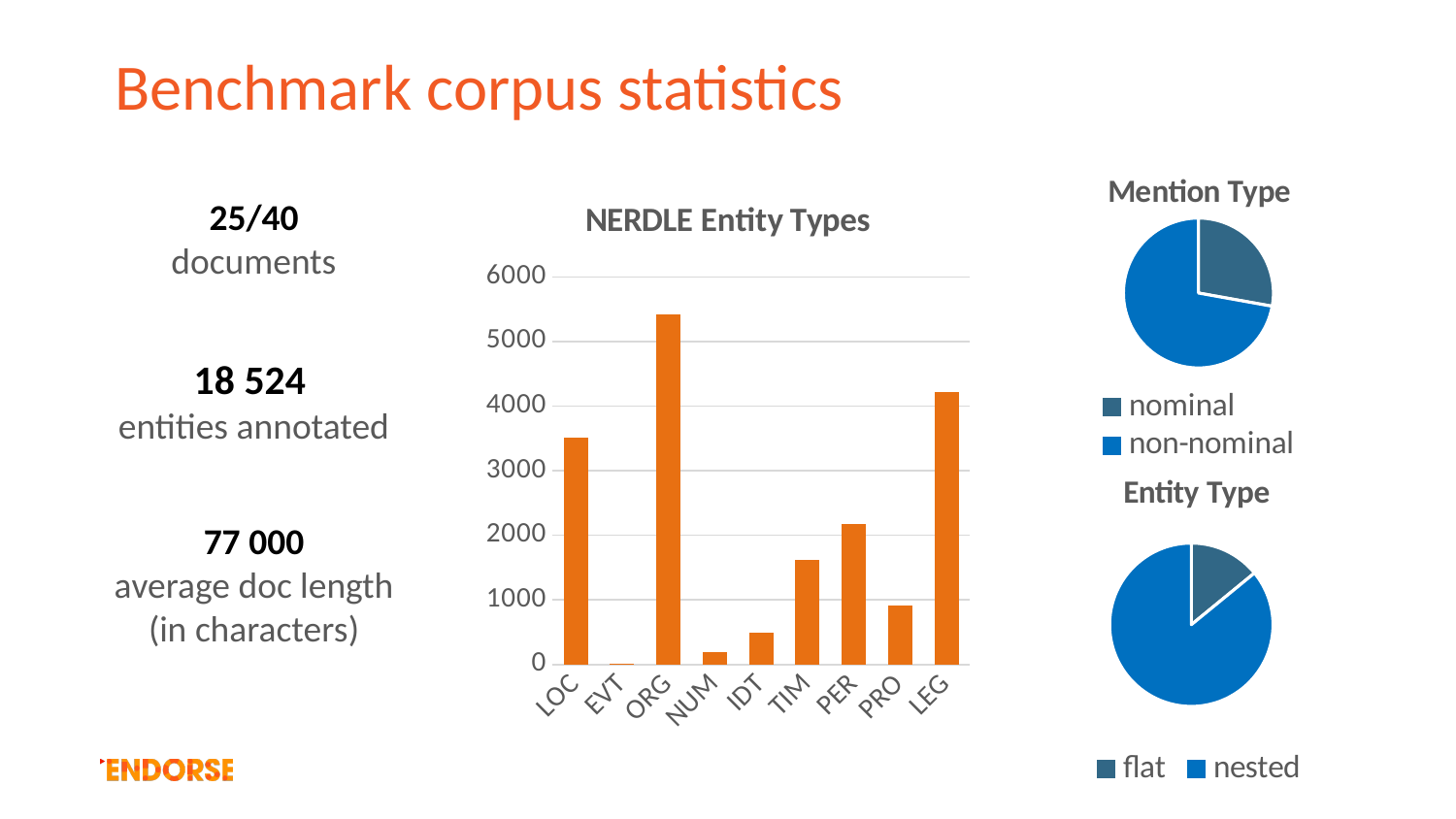
In the Mention Type pie chart, which slice is larger, nominal or non-nominal? non-nominal How many entity type categories are shown on the x axis of the NERDLE Entity Types chart? 9 In the NERDLE Entity Types chart, which is larger, the value for LEG or the value for PER? LEG How many entries does the legend of the Entity Type pie chart list? 2 In the NERDLE Entity Types chart, which is larger, the value for TIM or the value for NUM? TIM In the NERDLE Entity Types chart, which entity type has the highest count? ORG In the NERDLE Entity Types chart, is the value for ORG greater or less than 5000? greater What kind of chart is the NERDLE Entity Types chart? bar chart In the NERDLE Entity Types chart, is the value for PRO greater or less than 1000? less In the NERDLE Entity Types chart, is the value for LOC greater or less than 3000? greater In the NERDLE Entity Types chart, which entity type has the lowest count? EVT